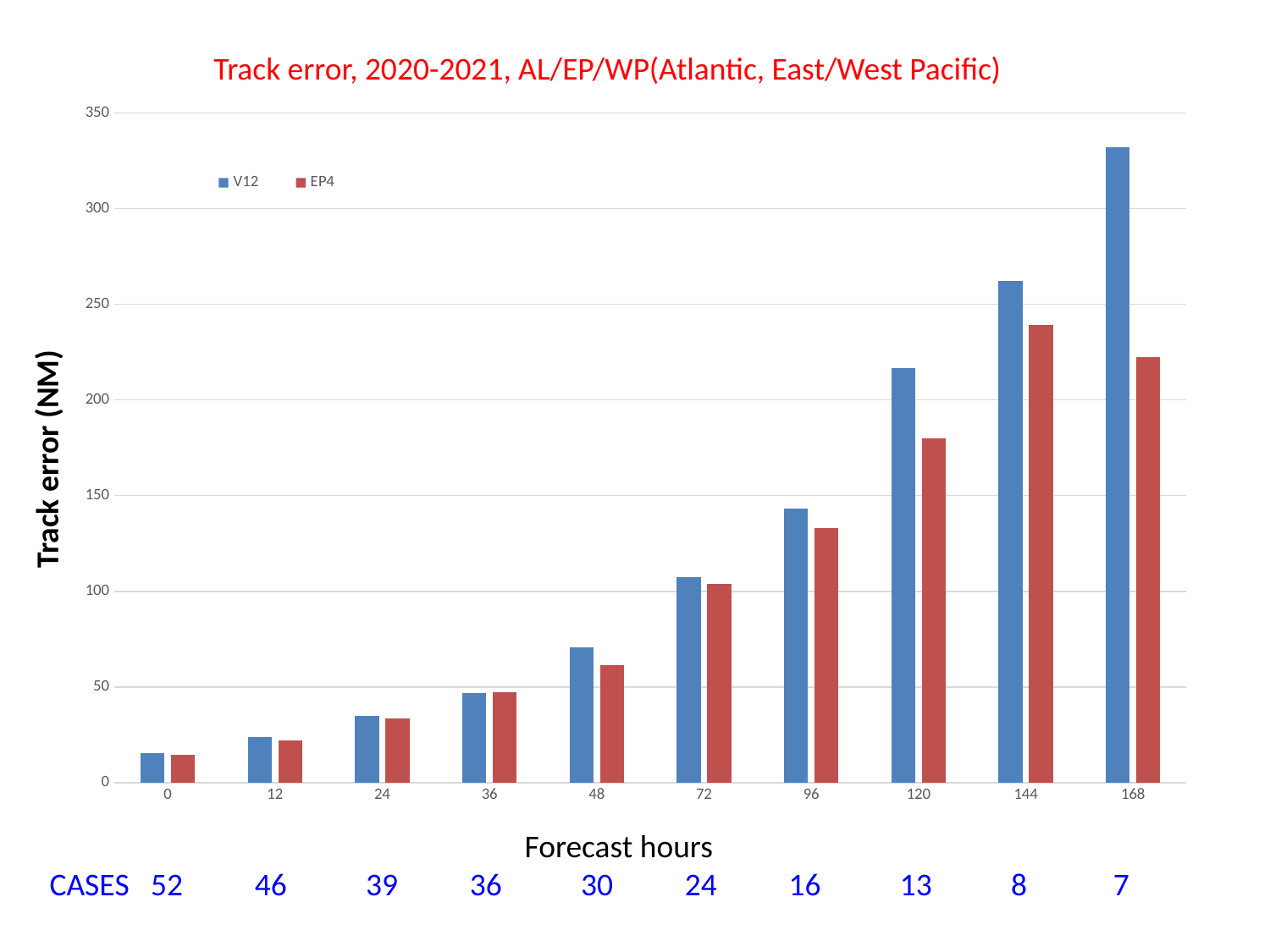
What is the title of the chart? Track error, 2020-2021, AL/EP/WP(Atlantic, East/West Pacific) Do the track errors rise or fall as forecast hours increase? rise At forecast hour 168, which series has the larger track error, V12 or EP4? V12 At which forecast hour is the V12 track error highest? 168 At which forecast hour is the EP4 track error lowest? 0 Which two series are listed in the legend? V12 and EP4 What kind of chart is shown on the slide? bar chart How many forecast-hour categories are plotted on the x axis? 10 How many series does the legend list? 2 Is the V12 track error at forecast hour 168 greater or less than 300? greater Is the EP4 track error at forecast hour 168 greater or less than 250? less Is the V12 track error at forecast hour 120 greater or less than 200? greater